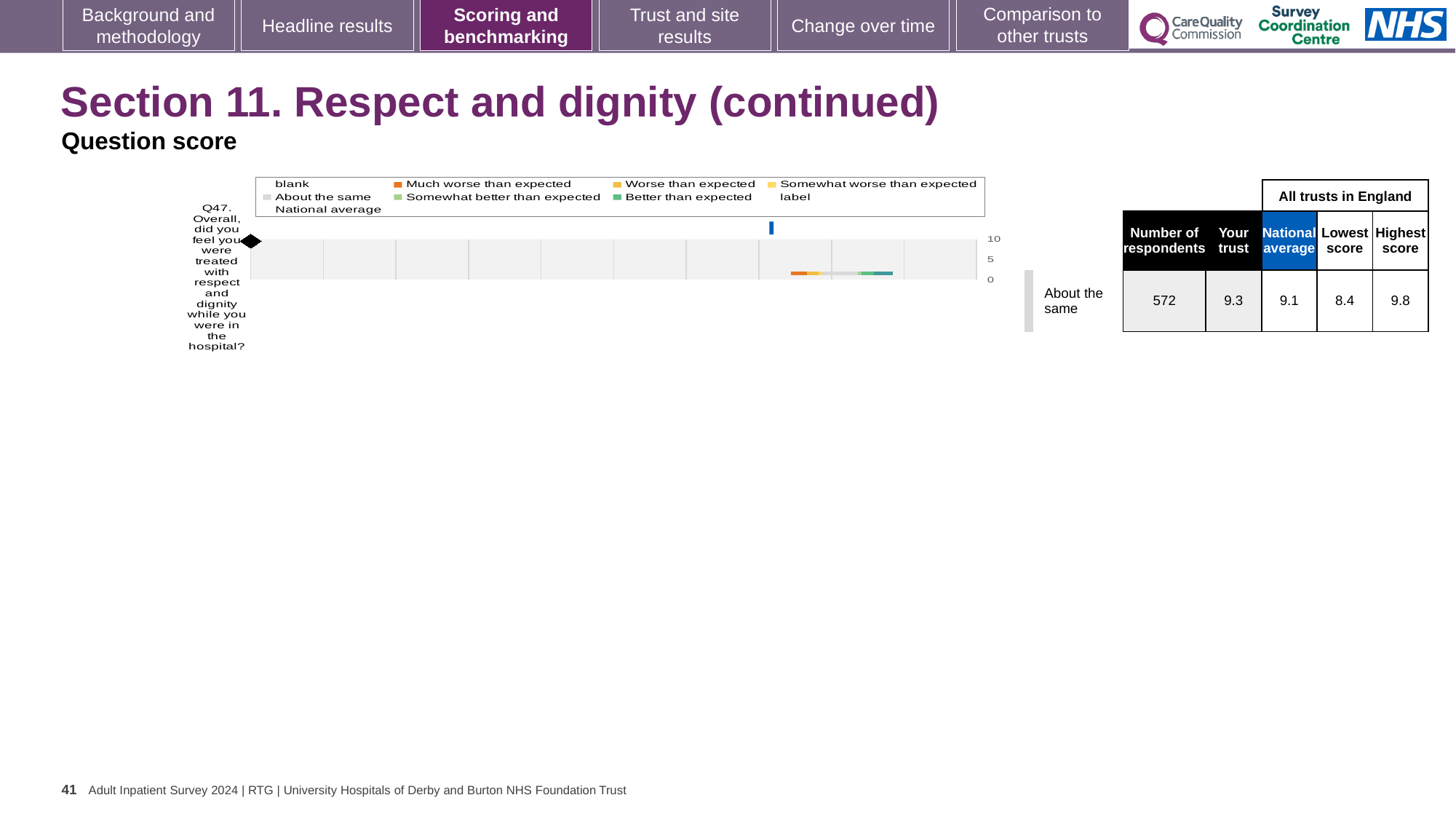
According to the table next to the chart, what is the lowest score among all trusts in England for Q47? 8.4 According to the table next to the chart, what is the national average score for Q47? 9.1 What is the difference between the 'Your trust' score and the national average for Q47? 0.2 What kind of chart is shown on the slide? bar chart According to the table next to the chart, what is the highest score among all trusts in England for Q47? 9.8 What is the highest value shown on the chart's vertical axis? 10 What benchmark category is the trust's Q47 score placed in, as labelled beside the chart? About the same Is the 'Your trust' score for Q47 larger or smaller than the national average? larger According to the table next to the chart, what is the number of respondents for Q47? 572 What is the difference between the highest score and the lowest score for Q47 in the table? 1.4 According to the table next to the chart, what is the 'Your trust' score for Q47? 9.3 Which question is plotted on the chart? Q47. Overall, did you feel you were treated with respect and dignity while you were in the hospital?